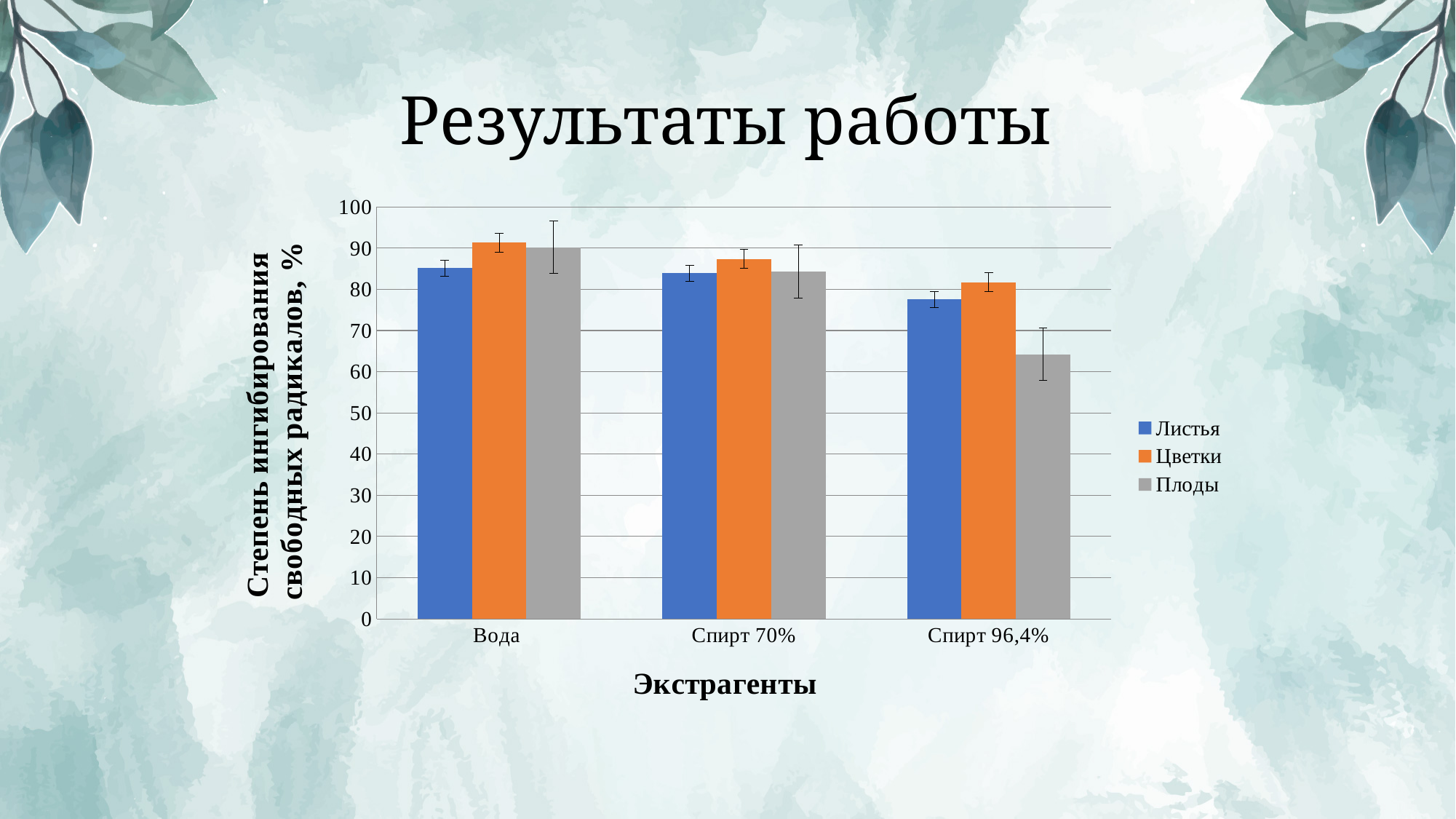
How many extractant categories are shown on the x axis? 3 What kind of chart is shown on the slide? bar chart Is the value for Цветки with Вода greater or less than 80? greater Is the value for Листья with Спирт 96,4% greater or less than 80? less Do the values for Листья rise or fall from Вода to Спирт 96,4% along the x axis? fall What is the title of the x axis? Экстрагенты How many series does the legend list? 3 For Спирт 96,4%, which is larger: Цветки or Плоды? Цветки Is the value for Плоды with Спирт 96,4% greater or less than 70? less Which is larger for Листья: the value for Вода or the value for Спирт 96,4%? Вода For Спирт 96,4%, which series has the highest value? Цветки Which bar is the lowest in the whole chart? Плоды, Спирт 96,4%